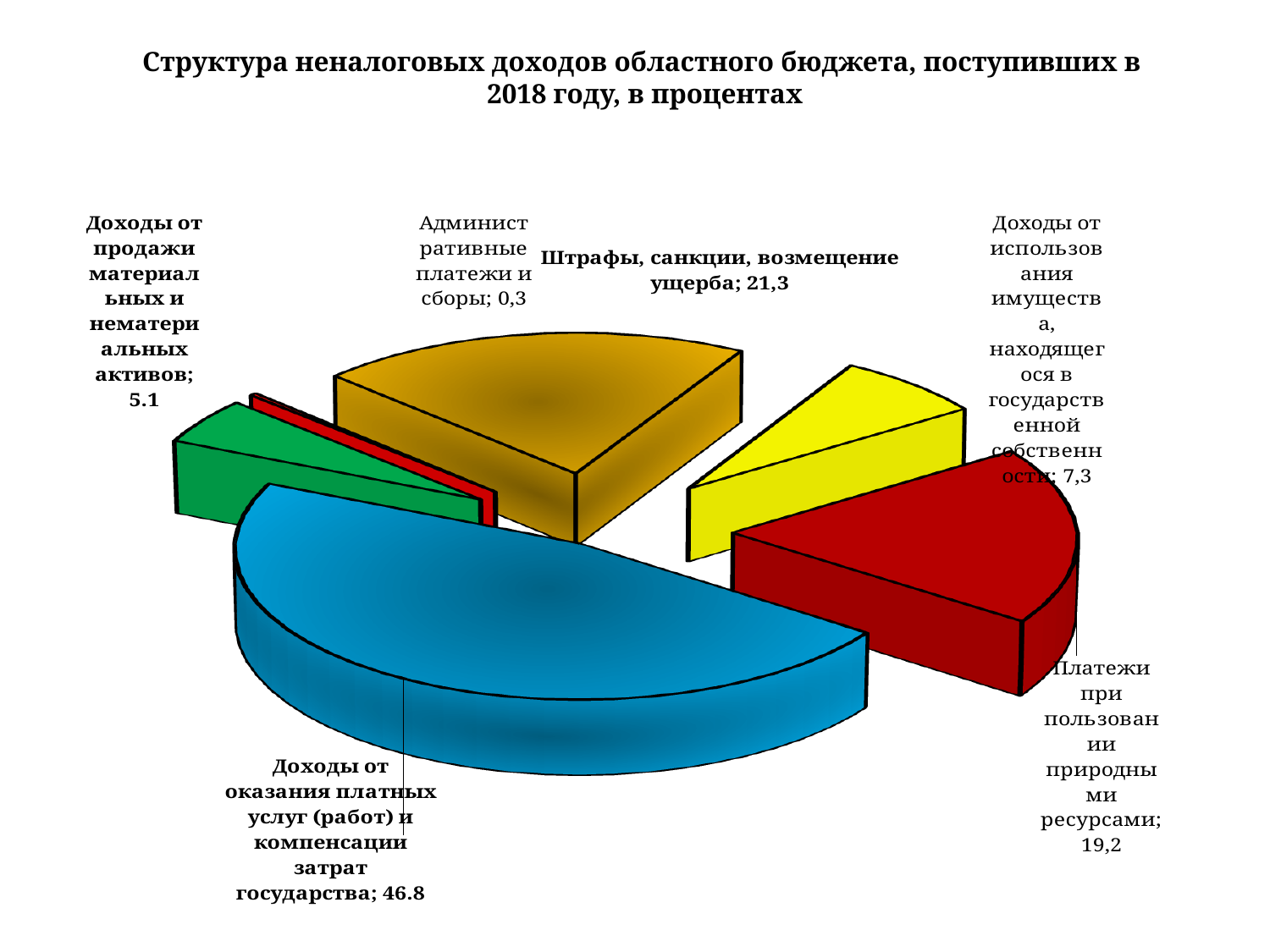
What is the value for «Штрафы, санкции, возмещение ущерба»? 21,3 Which is larger: «Штрафы, санкции, возмещение ущерба» or «Платежи при пользовании природными ресурсами»? Штрафы, санкции, возмещение ущерба What is the value for «Платежи при пользовании природными ресурсами»? 19,2 What colour is the slice for «Доходы от использования имущества, находящегося в государственной собственности»? Yellow What is the difference between «Доходы от оказания платных услуг (работ) и компенсации затрат государства» (46.8) and «Штрафы, санкции, возмещение ущерба» (21,3)? 25,5 Which category has the largest share of the pie? Доходы от оказания платных услуг (работ) и компенсации затрат государства How many categories (slices) does the pie chart have? 6 Which category has the smallest share of the pie? Административные платежи и сборы What is the value for «Административные платежи и сборы»? 0,3 What share of the pie does «Доходы от продажи материальных и нематериальных активов» represent? 5.1 What is the value for «Доходы от оказания платных услуг (работ) и компенсации затрат государства»? 46.8 What kind of chart is shown on the slide? Pie chart